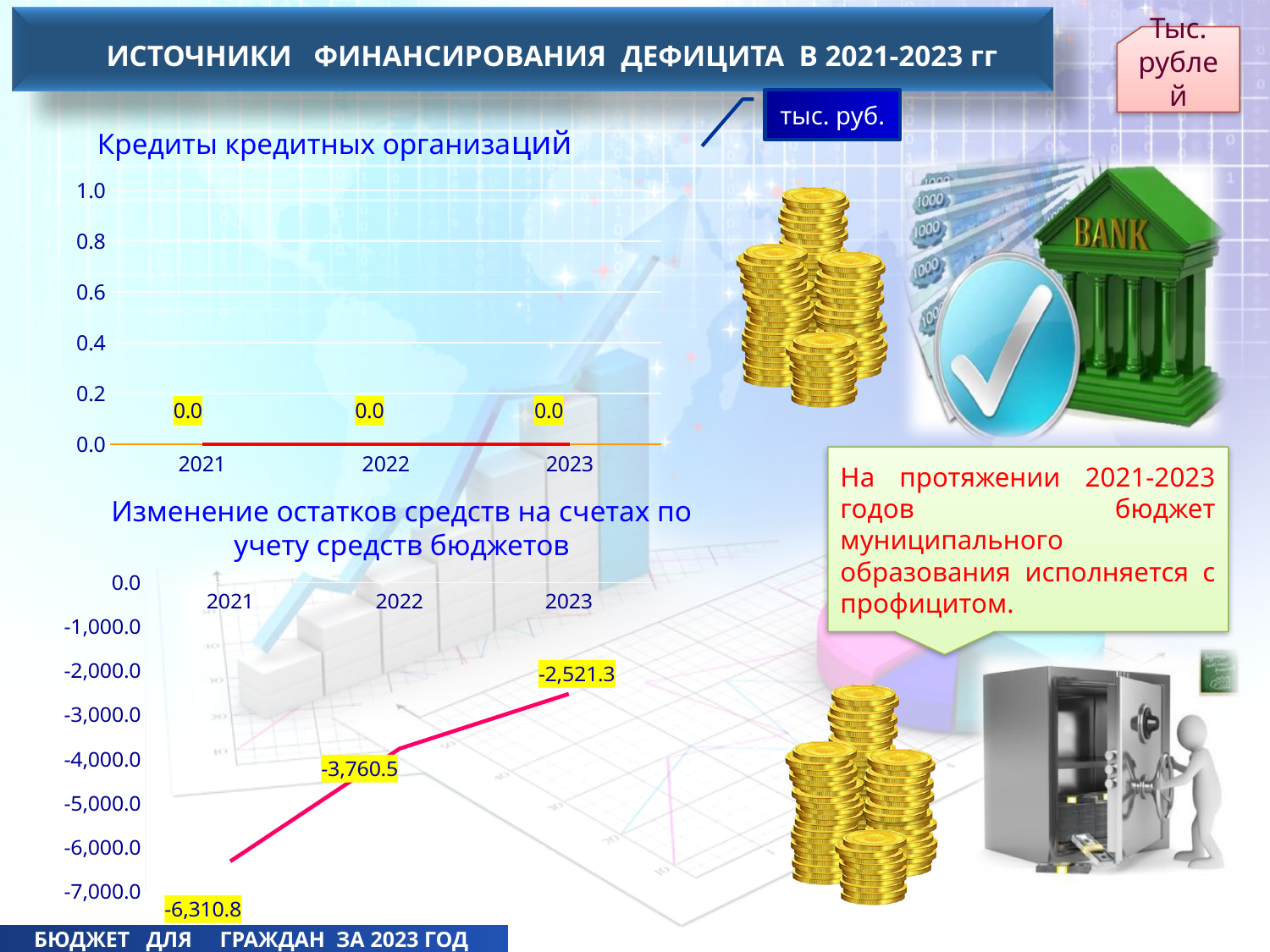
What kind of chart is 'Кредиты кредитных организаций'? line chart In the chart 'Изменение остатков средств на счетах по учету средств бюджетов', is the value for 2022 greater or less than -4,000.0? greater In the chart 'Изменение остатков средств на счетах по учету средств бюджетов', what is the value for 2021? -6,310.8 In the chart 'Кредиты кредитных организаций', what is the value for 2022? 0.0 In the chart 'Изменение остатков средств на счетах по учету средств бюджетов', what is the difference between the 2023 value and the 2021 value? 3,789.5 In the chart 'Изменение остатков средств на счетах по учету средств бюджетов', which year has the highest value? 2023 What unit of measurement is indicated for the charts on the slide? тыс. руб. In the chart 'Изменение остатков средств на счетах по учету средств бюджетов', do the values rise or fall from 2021 to 2023? rise In the chart 'Изменение остатков средств на счетах по учету средств бюджетов', what is the value for 2023? -2,521.3 In the chart 'Изменение остатков средств на счетах по учету средств бюджетов', what is the value for 2022? -3,760.5 In the chart 'Кредиты кредитных организаций', how many years are plotted on the x axis? 3 In the chart 'Изменение остатков средств на счетах по учету средств бюджетов', which year has the lowest value? 2021